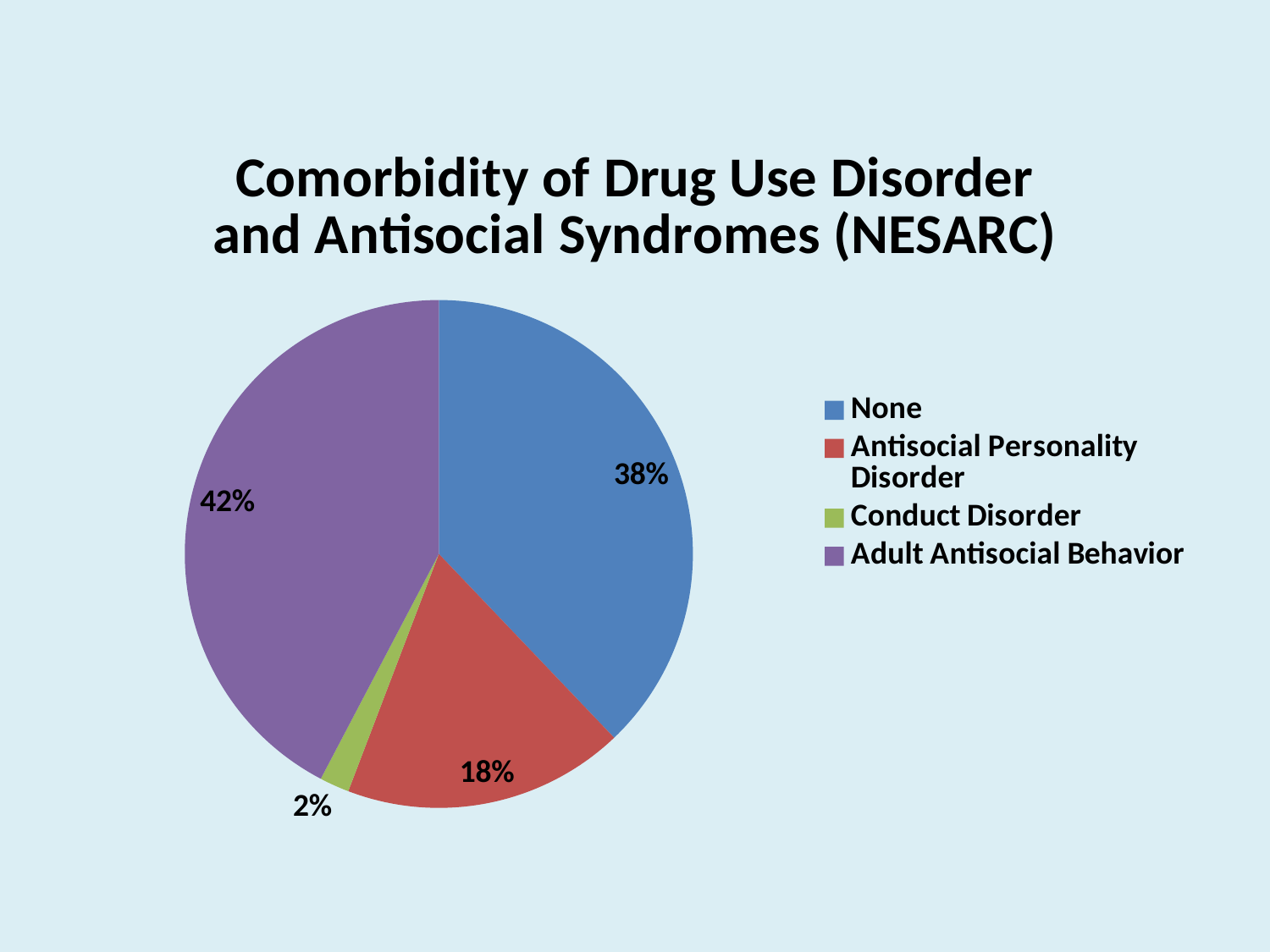
Which is larger, the None slice or the Antisocial Personality Disorder slice? None What percentage of the pie is labelled None? 38% How many categories does the legend list? 4 What kind of chart is shown on the slide? pie chart What percentage of the pie is labelled Antisocial Personality Disorder? 18% What is the difference in percentage points between the Adult Antisocial Behavior slice and the None slice? 4 Which category has the smallest slice of the pie? Conduct Disorder What is the title of the chart? Comorbidity of Drug Use Disorder and Antisocial Syndromes (NESARC) What percentage of the pie is labelled Adult Antisocial Behavior? 42% Which category has the largest slice of the pie? Adult Antisocial Behavior What percentage of the pie is labelled Conduct Disorder? 2% What colour is the Conduct Disorder slice? green